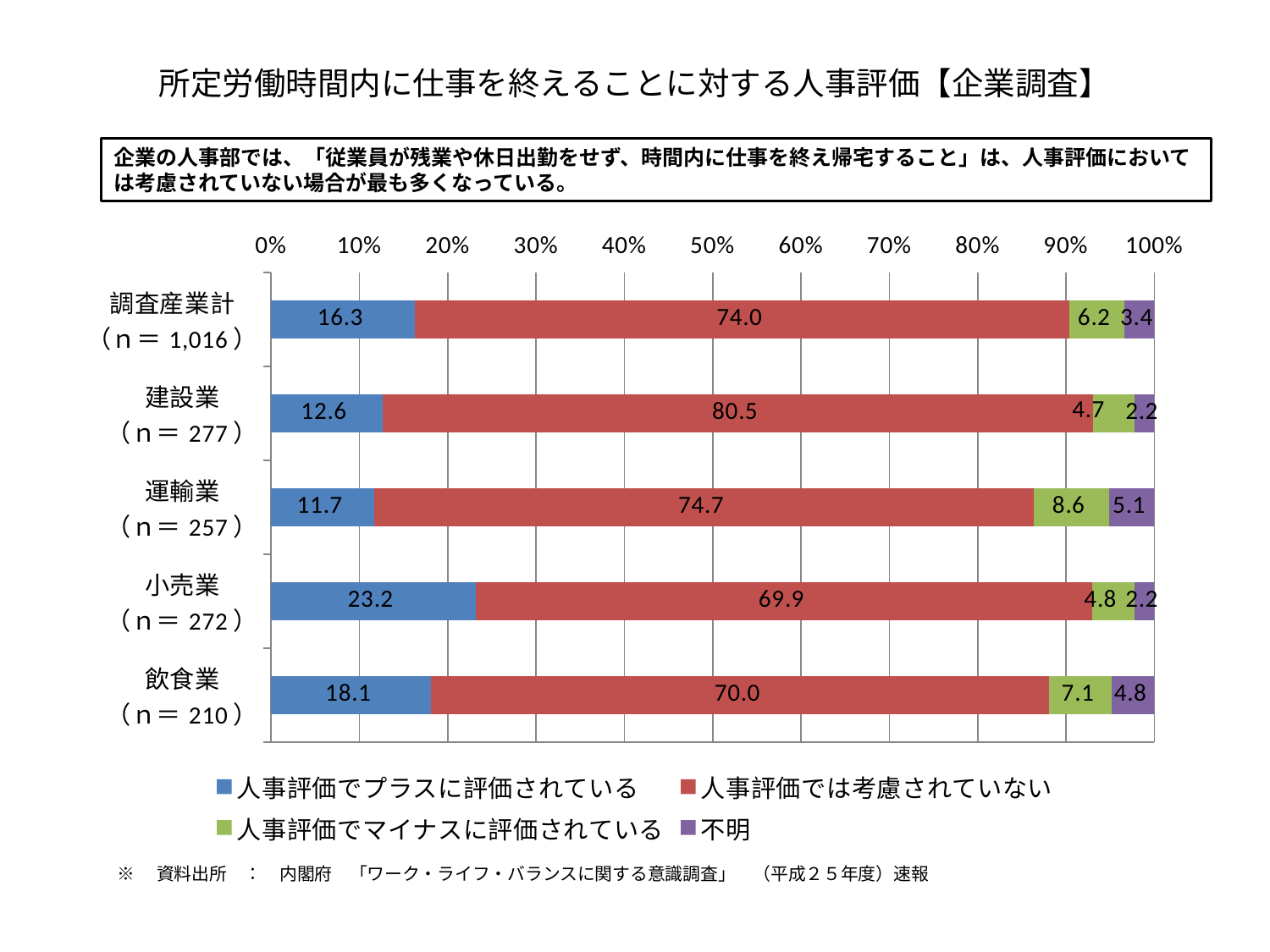
What is the difference between the 人事評価では考慮されていない values for 建設業 (n=277) and 小売業 (n=272)? 10.6 What is the value of 人事評価では考慮されていない for 建設業 (n=277)? 80.5 What is the value of 人事評価でプラスに評価されている for 小売業 (n=272)? 23.2 What is the value of 人事評価でマイナスに評価されている for 飲食業 (n=210)? 7.1 Which category has the highest value for 人事評価でプラスに評価されている? 小売業 (n=272) What is the total of the four labelled segments for 調査産業計 (n=1,016)? 99.9 What kind of chart is shown on the slide? Stacked bar chart How many categories are shown on the vertical axis of the chart? 5 What is the value of 不明 for 運輸業 (n=257)? 5.1 Which category has the lowest value for 人事評価でプラスに評価されている? 運輸業 (n=257) Which is larger: the 人事評価でマイナスに評価されている value for 運輸業 (n=257) or for 調査産業計 (n=1,016)? 運輸業 (n=257) How many series does the legend list? 4